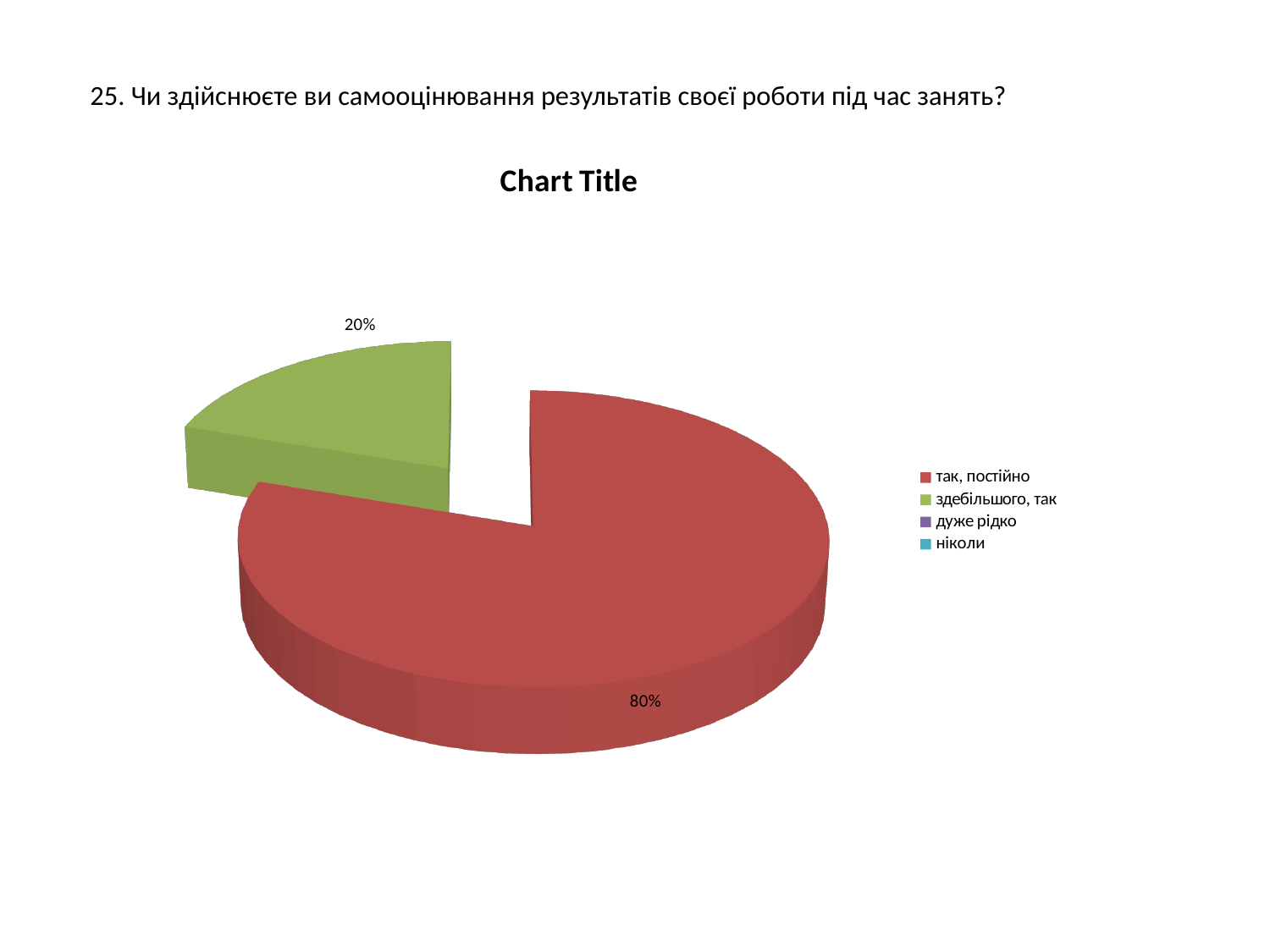
How many slices with data labels are visible in the pie? 2 How many entries does the legend list? 4 Which category has the largest slice of the pie? так, постійно Is the share for "так, постійно" greater or less than 50%? greater What colour is the slice for "здебільшого, так"? green What kind of chart is shown on the slide? pie chart Which of the two labelled slices is larger, "так, постійно" or "здебільшого, так"? так, постійно What is the combined share of the "так, постійно" and "здебільшого, так" slices? 100% What share of the pie does "так, постійно" have? 80% What is the difference in percentage points between the "так, постійно" slice and the "здебільшого, так" slice? 60% What share of the pie does "здебільшого, так" have? 20% What is the title printed above the pie chart? Chart Title